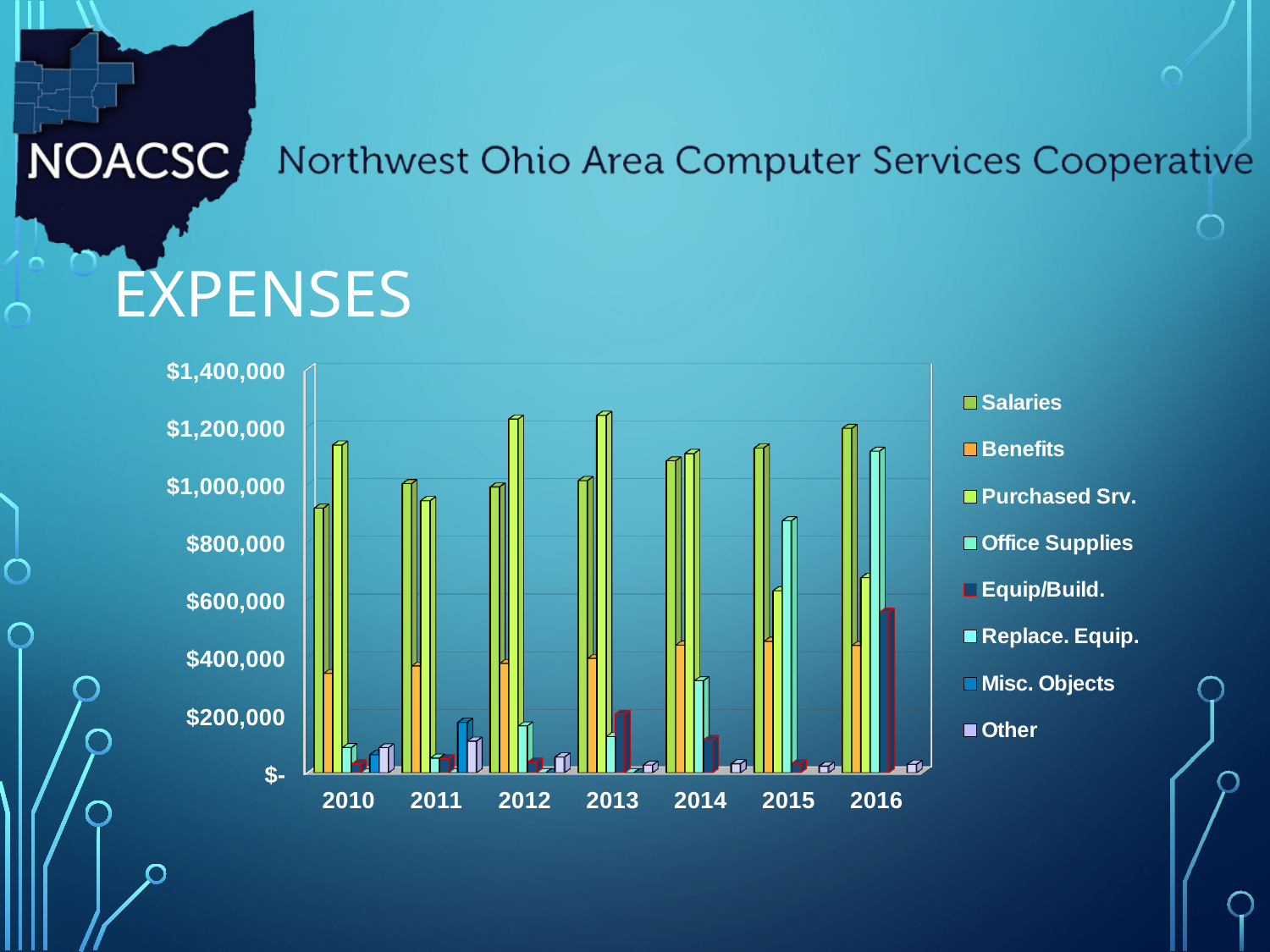
In which year is the Salaries value the highest? 2016 Is the value for Equip/Build. in 2016 greater or less than $400,000? greater What is the title of the chart? EXPENSES How many years are shown on the x axis of the chart? 7 In 2013, which is larger: Salaries or Purchased Srv.? Purchased Srv. How many series does the chart legend list? 8 Which series is listed first in the chart legend? Salaries What kind of chart is shown on the slide? bar chart Is the value for Salaries in 2010 greater or less than $1,000,000? less Is the value for Purchased Srv. in 2010 greater or less than $1,000,000? greater